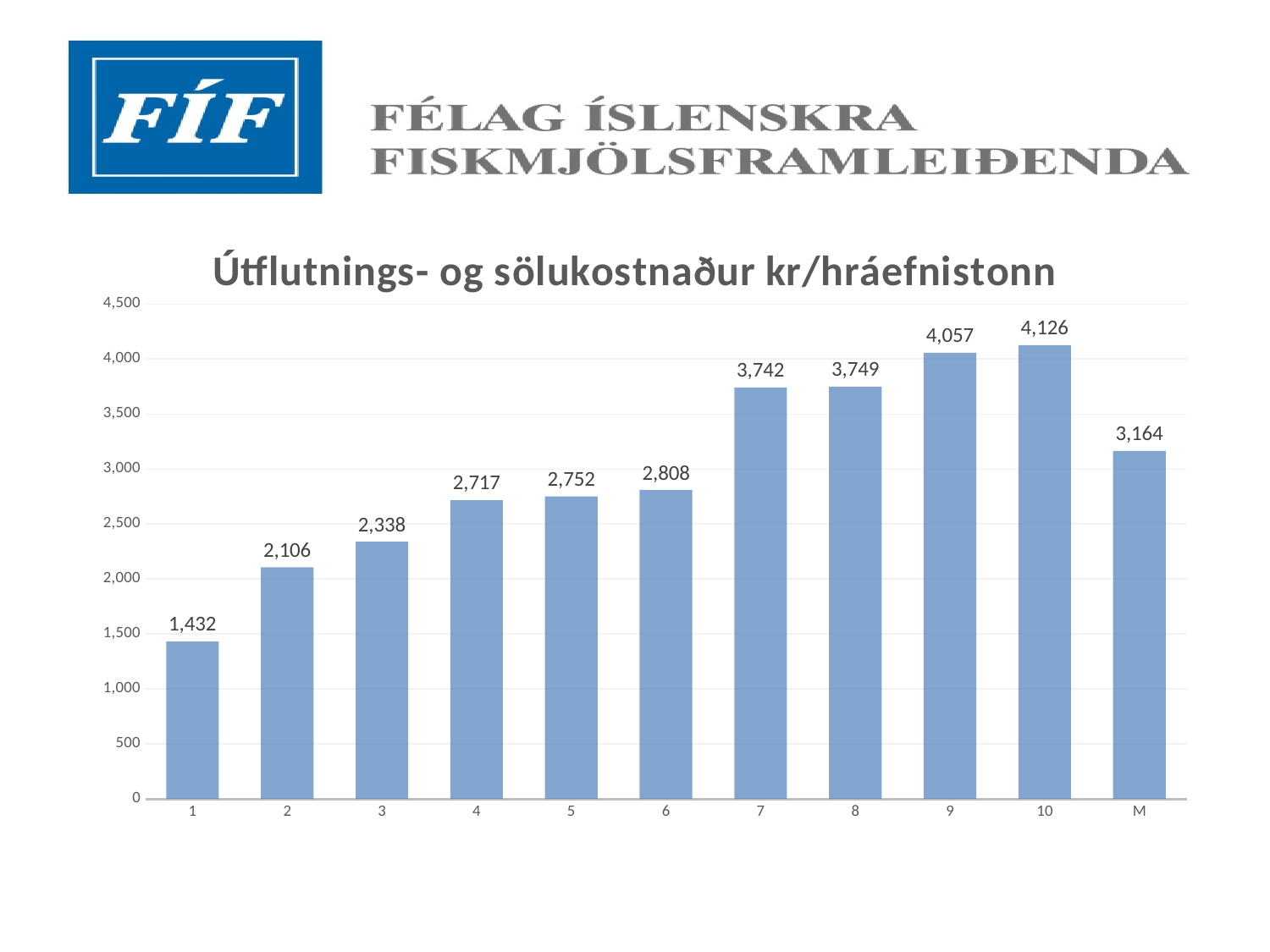
Is the value for category 3 greater or less than 2,500? less What is the value for category 1? 1,432 How many categories are shown on the x axis? 11 What kind of chart is shown on the slide? bar chart What is the title of the chart? Útflutnings- og sölukostnaður kr/hráefnistonn Which category has the highest value? 10 What is the difference between the values for category 10 and category 9? 69 What is the difference between the values for category 2 and category 1? 674 What is the value for category M? 3,164 What is the value for category 7? 3,742 Which category has the lowest value? 1 Which is larger, the value for category 6 or the value for category M? M